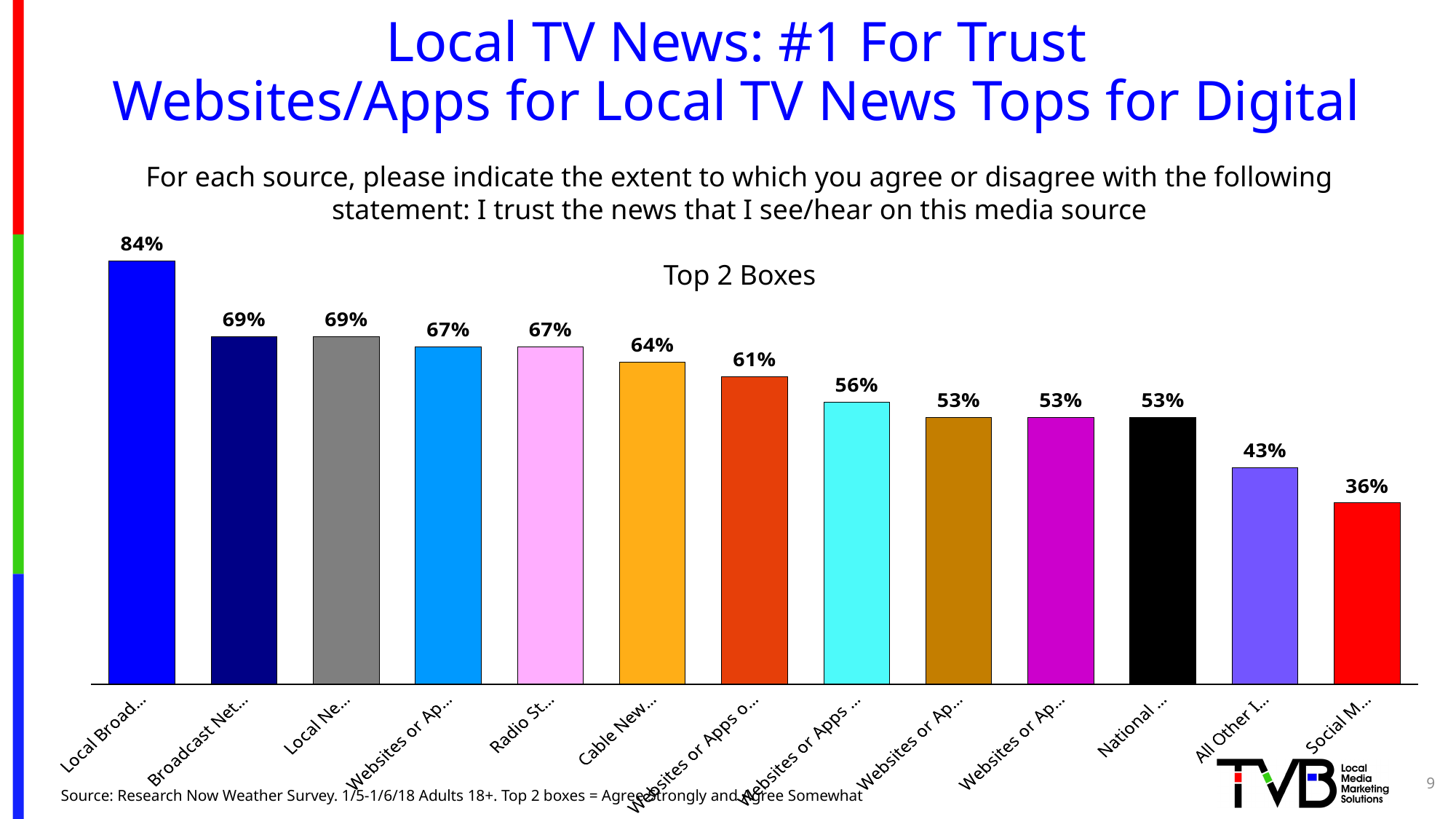
Which is larger, the value for Radio St... or the value for Cable New...? Radio St... How many bars are plotted in the chart? 13 Which category has the lowest value? Social M... What is the title shown above the chart's plot area? Top 2 Boxes Which category has the highest value? Local Broad... What is the value of the leftmost bar (Local Broad...)? 84% What is the value for Radio St...? 67% What is the difference between the leftmost bar (84%) and the rightmost bar (36%)? 48 percentage points What is the value of the rightmost bar (Social M...)? 36% What is the value for Cable New...? 64% What is the value for All Other I...? 43% What type of chart is shown on the slide? bar chart